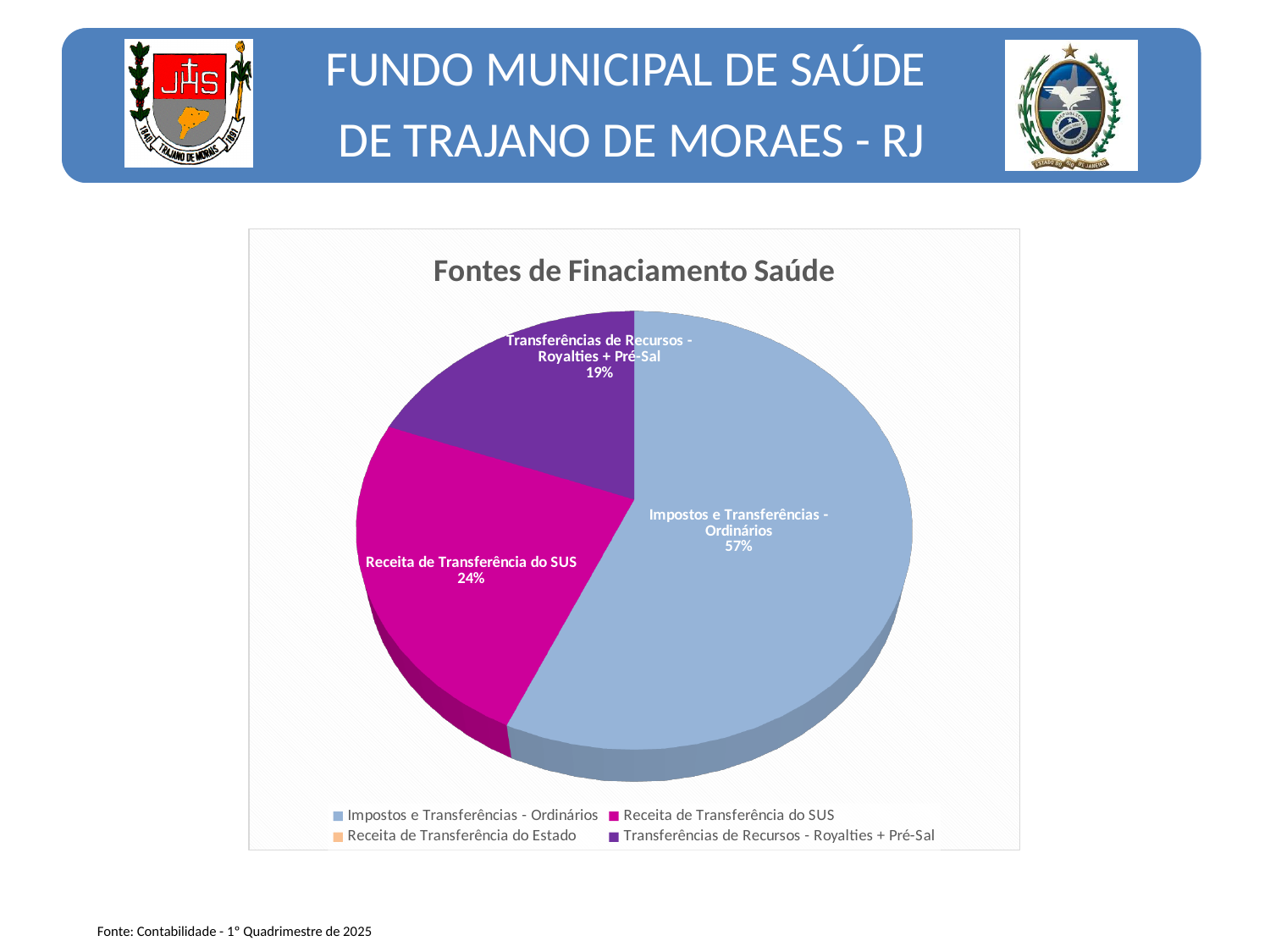
Which is larger: the share for Receita de Transferência do SUS or the share for Transferências de Recursos - Royalties + Pré-Sal? Receita de Transferência do SUS What is the difference in percentage points between Receita de Transferência do SUS and Transferências de Recursos - Royalties + Pré-Sal? 5 What share of the pie is labelled for Transferências de Recursos - Royalties + Pré-Sal? 19% What share of the pie is labelled for Impostos e Transferências - Ordinários? 57% Among the slices with a printed percentage, which category has the smallest share? Transferências de Recursos - Royalties + Pré-Sal Which category has the largest slice of the pie? Impostos e Transferências - Ordinários What share of the pie is labelled for Receita de Transferência do SUS? 24% How many entries does the legend list? 4 Which legend entry does not appear as a visible slice with a percentage label in the pie? Receita de Transferência do Estado What type of chart is shown on the slide? Pie chart What is the difference in percentage points between Impostos e Transferências - Ordinários and Receita de Transferência do SUS? 33 What is the title of the chart? Fontes de Finaciamento Saúde